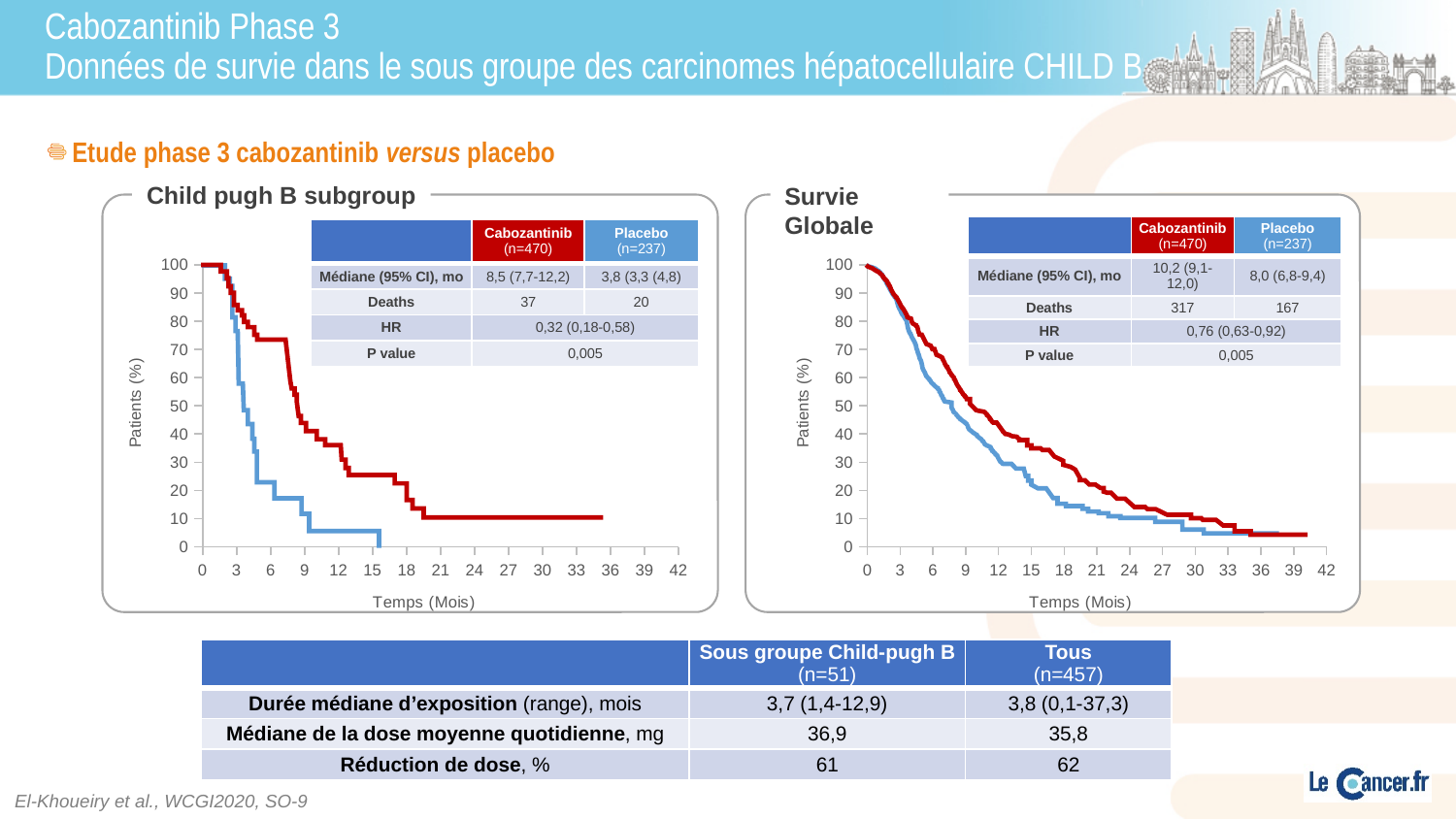
In the 'Child pugh B subgroup' chart, is the value of the red cabozantinib curve at 6 months greater or less than 50? greater In the 'Survie Globale' chart, what is the P value? 0,005 What kind of chart is the 'Child pugh B subgroup' chart? line chart In the 'Child pugh B subgroup' chart, do the curves rise or fall along the x axis? fall In the 'Child pugh B subgroup' chart, how many deaths are reported for placebo? 20 What is the label of the x axis in the 'Survie Globale' chart? Temps (Mois) In the 'Child pugh B subgroup' chart, what is the HR? 0,32 (0,18-0,58) In the 'Child pugh B subgroup' chart, what is the difference in deaths between cabozantinib and placebo? 17 In the 'Child pugh B subgroup' chart, what is the median (95% CI) in months for cabozantinib? 8,5 (7,7-12,2) In the 'Survie Globale' chart, what is the HR? 0,76 (0,63-0,92) In the 'Survie Globale' chart, what is the median (95% CI) in months for placebo? 8,0 (6,8-9,4) In the 'Survie Globale' chart, how many deaths are reported for cabozantinib? 317